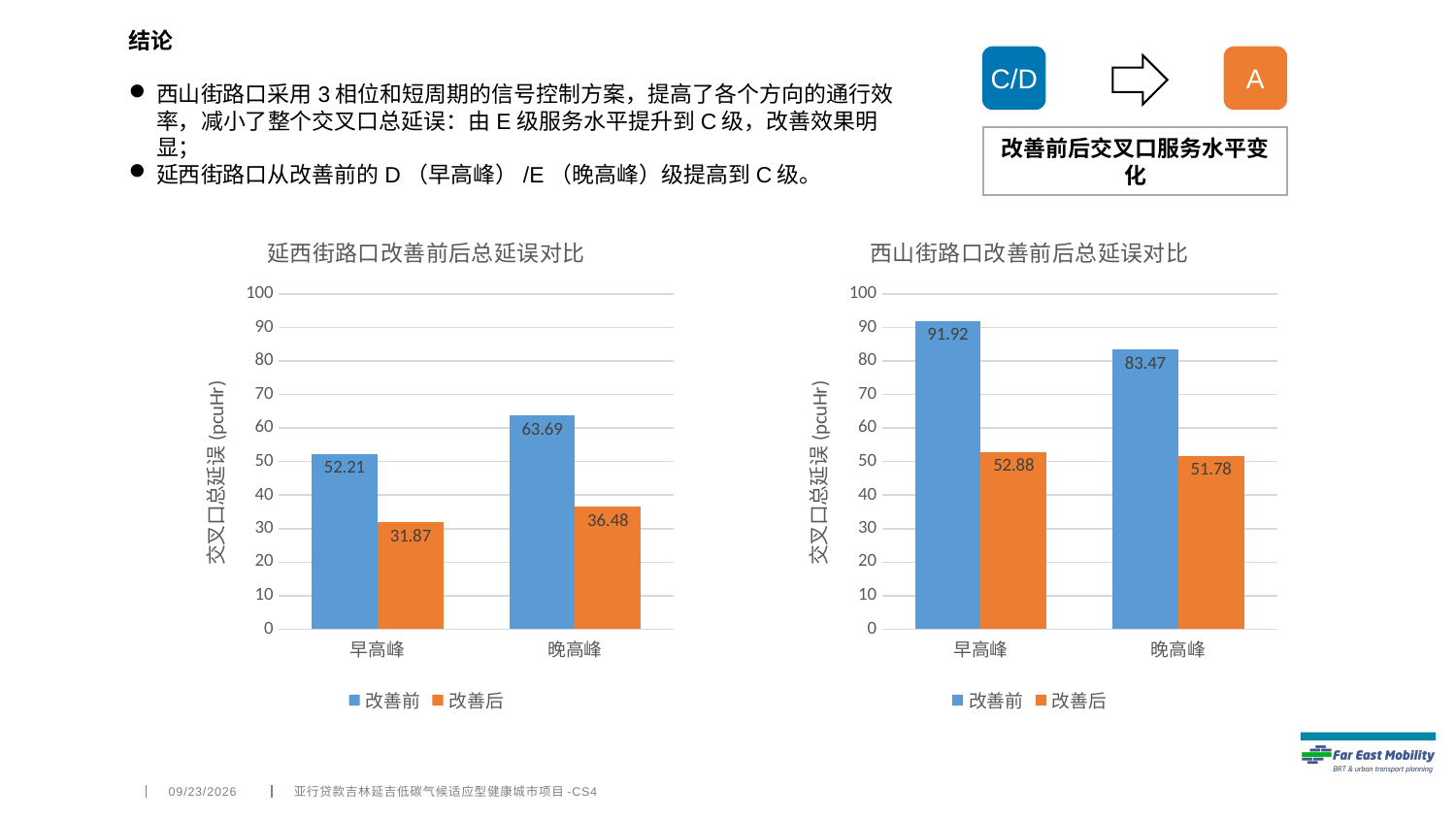
What kind of chart is the chart titled 延西街路口改善前后总延误对比? bar chart In the chart titled 西山街路口改善前后总延误对比, what is the value for 改善前 at 早高峰? 91.92 In the chart titled 延西街路口改善前后总延误对比, what is the value for 改善后 at 晚高峰? 36.48 In the chart titled 延西街路口改善前后总延误对比, which is larger: 改善前 at 晚高峰 or 改善前 at 早高峰? 改善前 at 晚高峰 In the chart titled 西山街路口改善前后总延误对比, what is the difference between 改善前 and 改善后 at 晚高峰? 31.69 In the chart titled 延西街路口改善前后总延误对比, what is the value for 改善前 at 早高峰? 52.21 In the chart titled 延西街路口改善前后总延误对比, what is the difference between 改善前 and 改善后 at 早高峰? 20.34 How many series does the legend of the chart titled 西山街路口改善前后总延误对比 list? 2 In the chart titled 西山街路口改善前后总延误对比, which category has the highest 改善前 value? 早高峰 In the chart titled 延西街路口改善前后总延误对比, which category has the lowest 改善后 value? 早高峰 In the chart titled 西山街路口改善前后总延误对比, is the value for 改善后 at 早高峰 greater or less than 60? less In the chart titled 西山街路口改善前后总延误对比, what is the value for 改善后 at 晚高峰? 51.78